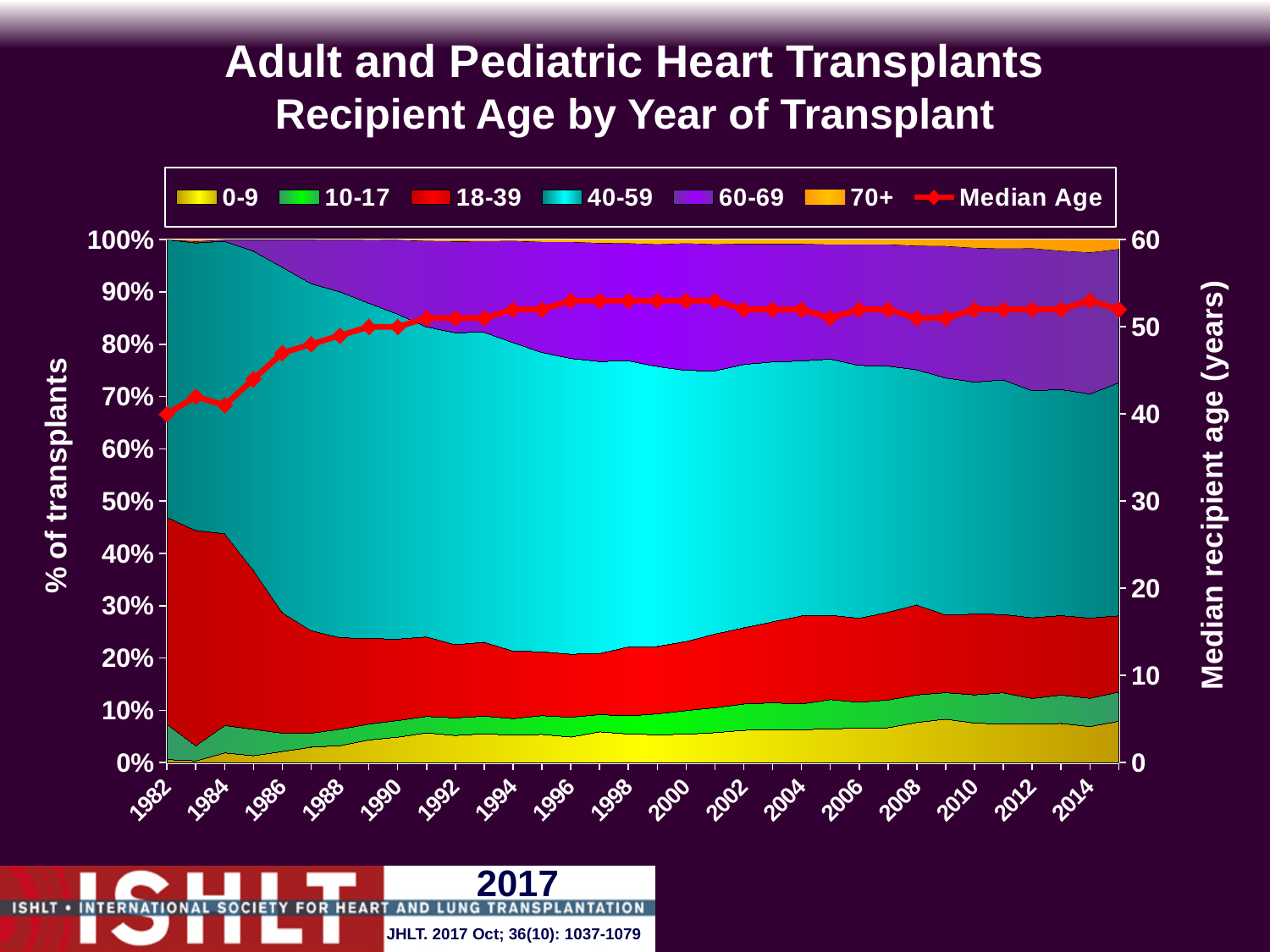
Is the share of transplants for the 0-9 age group in 2014 greater or less than 10%? less Does the share of transplants for the 18-39 age group rise or fall from 1982 to 2014? Falls In 2014, which age group has the larger share of transplants, 18-39 or 60-69? 60-69 How many series does the legend list? 7 Which age group accounts for the largest share of transplants in 2014? 40-59 Which legend entry is plotted as a line rather than a stacked area? Median Age What is the title of the chart? Adult and Pediatric Heart Transplants Recipient Age by Year of Transplant What kind of chart is this? Stacked area chart with a line Is the Median Age value in 1982 greater or less than 50 years? less Does the Median Age line rise or fall from 1982 to 2014? Rises Is the Median Age value in 2014 greater or less than 50 years? greater